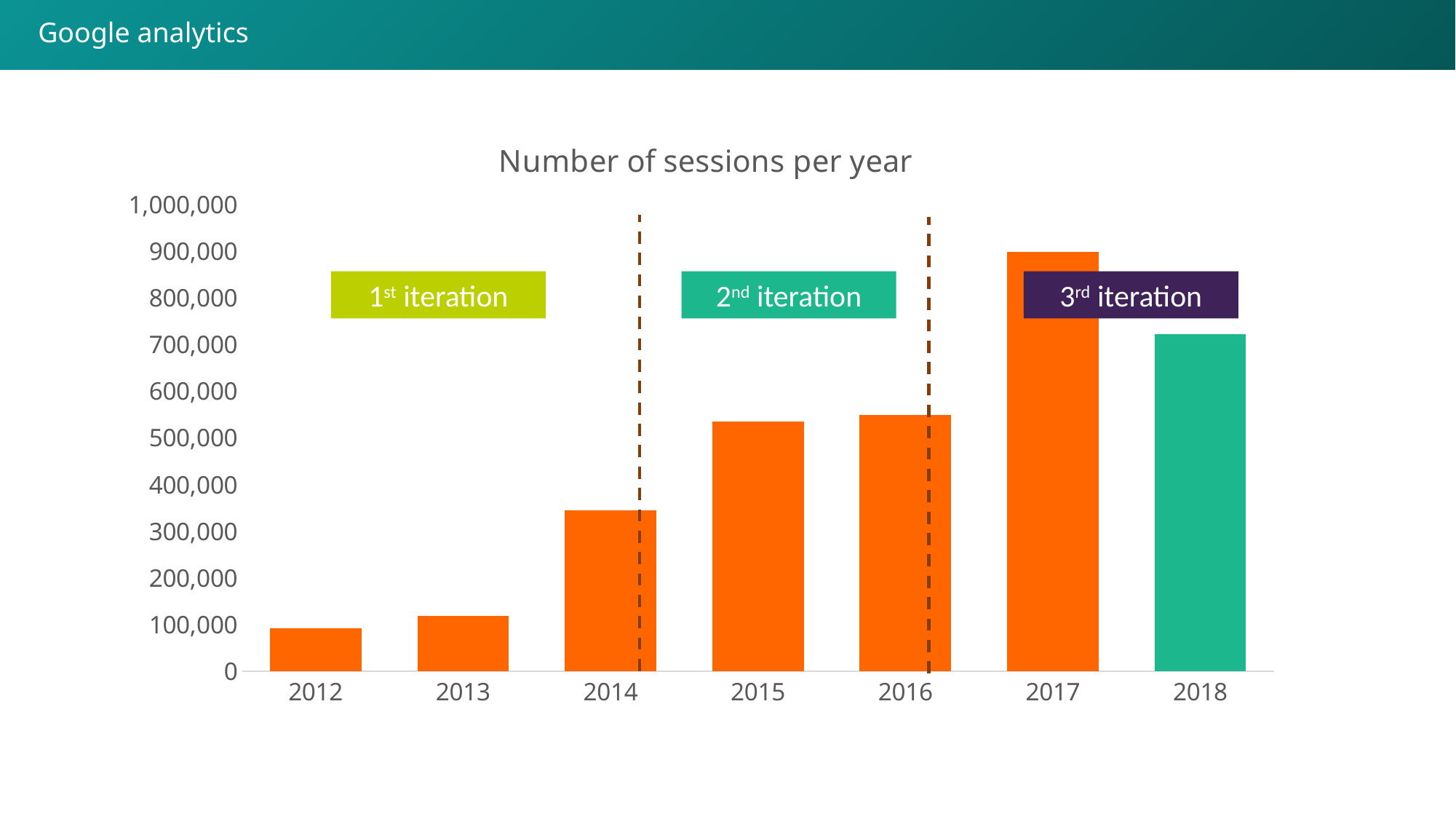
How many iteration labels are shown on the chart? 3 Which year has more sessions, 2013 or 2014? 2014 Is the value for 2018 greater or less than 700,000? greater Which year has the lowest number of sessions? 2012 What is the title of the chart? Number of sessions per year What kind of chart is shown on the slide? bar chart Which year has the highest number of sessions? 2017 Is the value for 2014 greater or less than 400,000? less Which year has more sessions, 2017 or 2018? 2017 Do the number of sessions rise or fall from 2012 to 2017? rise How many years are shown on the x axis of the chart? 7